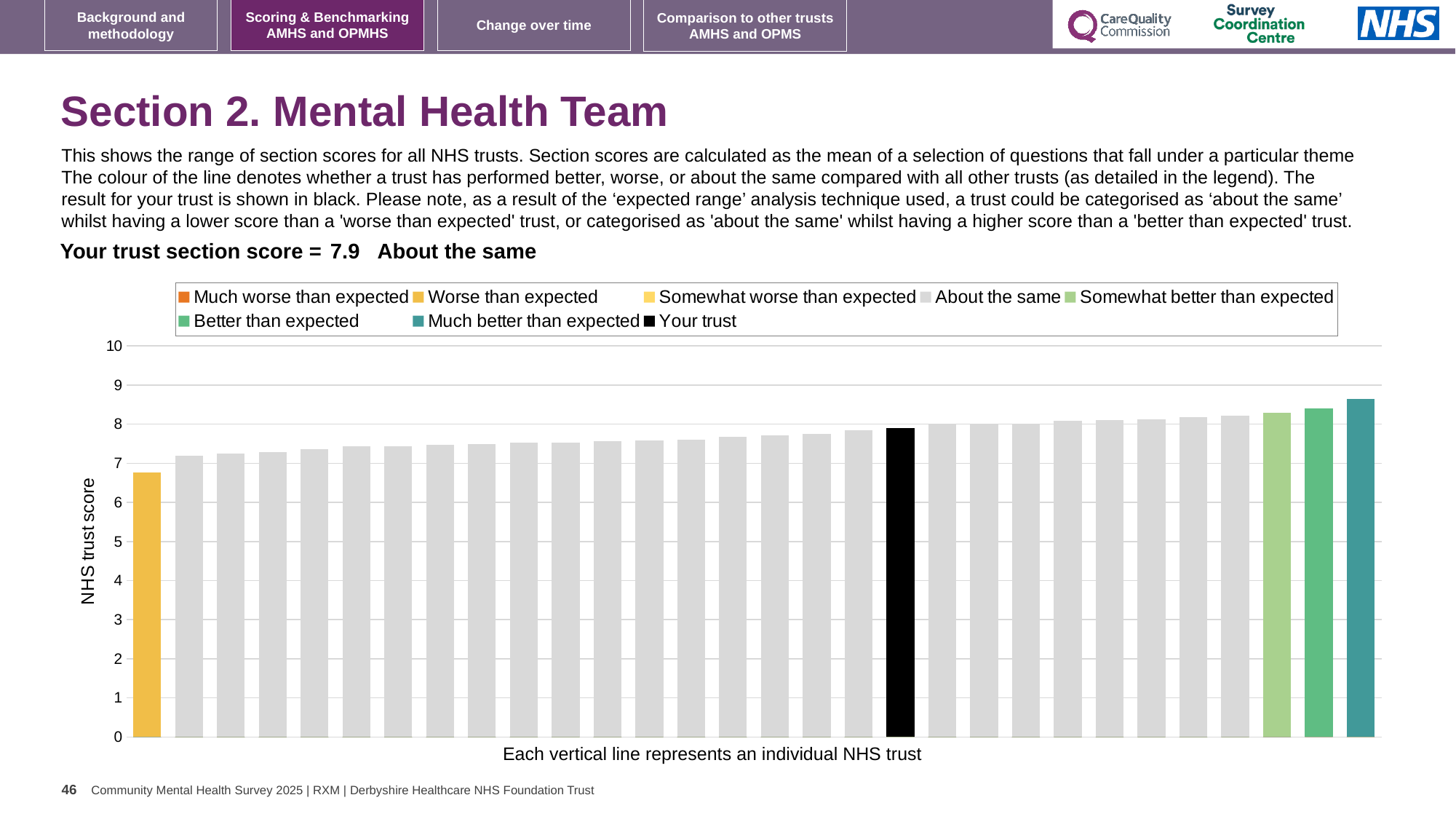
Is the value of the tallest bar greater or less than 9? less Is the value of the tallest bar (rightmost, teal) greater or less than 8? greater Which legend category does the shortest bar belong to? Worse than expected What kind of chart is shown on the slide? Bar chart What is the section score for your trust shown on the slide? 7.9 Which legend category does the tallest bar belong to? Much better than expected What colour is the bar representing your trust? Black How many entries does the chart legend list? 8 Is the value of the leftmost (yellow) bar greater or less than 7? less Do the bar values rise or fall from left to right along the x axis? Rise Is the bar for your trust taller or shorter than the leftmost yellow bar? Taller What is the label on the vertical axis of the chart? NHS trust score